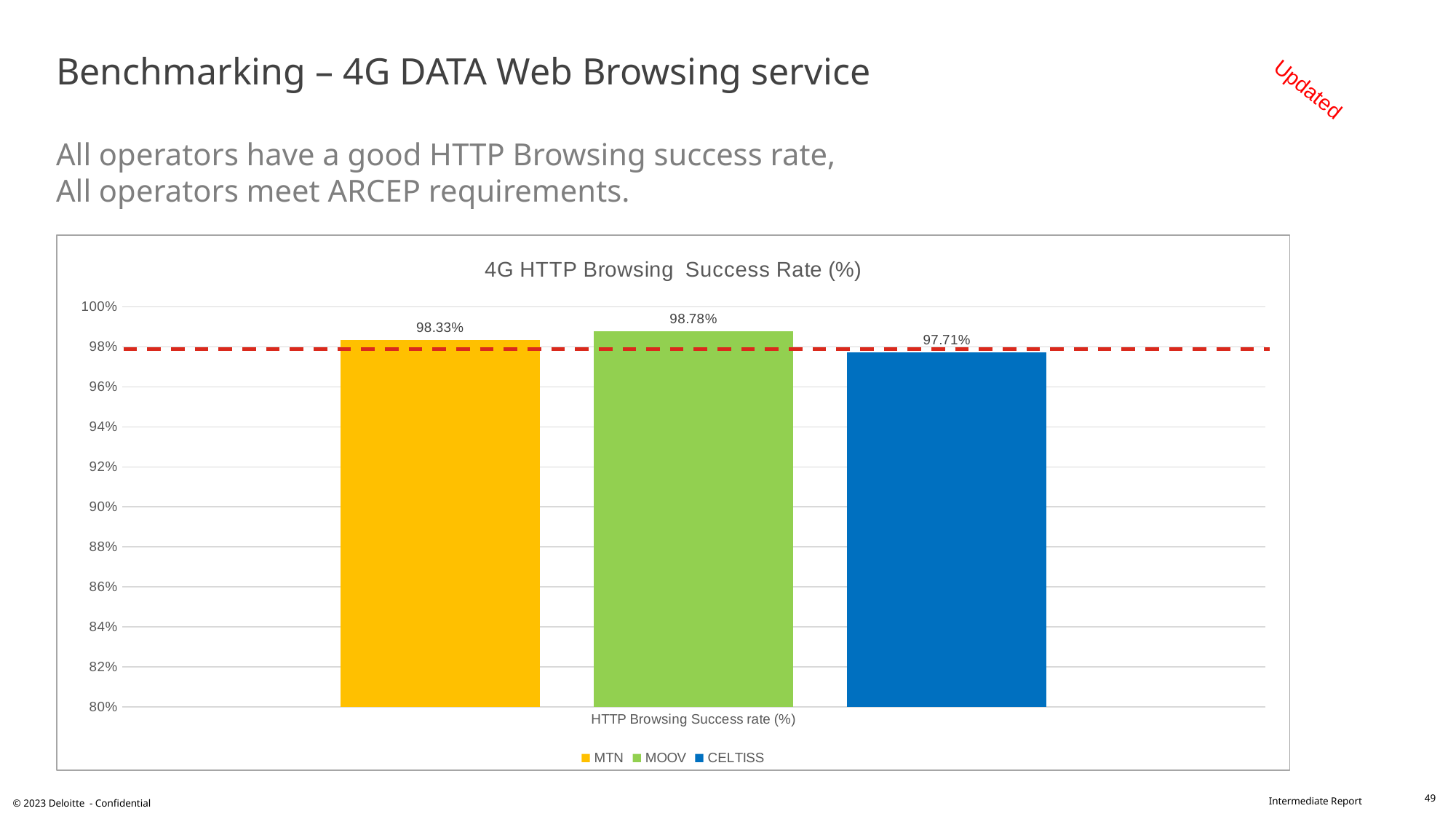
What kind of chart is shown on the slide? Bar chart Which operator has the highest HTTP Browsing Success rate? MOOV What is the HTTP Browsing Success rate for MTN? 98.33% What is the difference between the MOOV and CELTISS HTTP Browsing Success rates? 1.07% Which operator has the lowest HTTP Browsing Success rate? CELTISS What is the HTTP Browsing Success rate for CELTISS? 97.71% Which has a higher HTTP Browsing Success rate, MTN or CELTISS? MTN What is the HTTP Browsing Success rate for MOOV? 98.78% What is the difference between the MOOV and MTN HTTP Browsing Success rates? 0.45% What is the title of the chart? 4G HTTP Browsing Success Rate (%) Is the value for CELTISS greater or less than 98%? less How many series does the legend list? 3